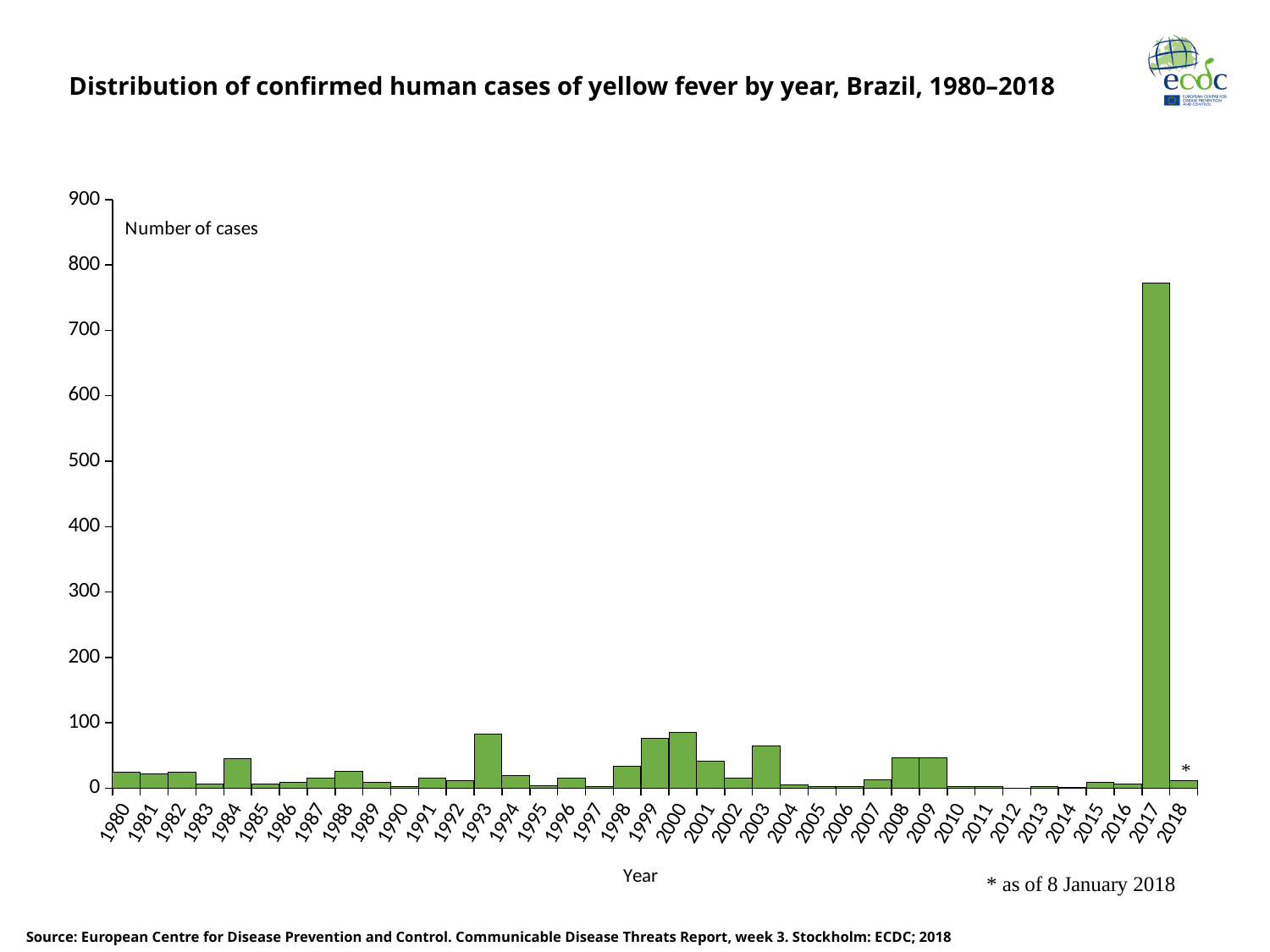
How many years are shown on the x axis of the chart? 39 Which year had more cases, 2003 or 2004? 2003 Is the number of cases in 2017 greater or less than 700? greater What does the asterisk next to the 2018 bar indicate? as of 8 January 2018 Is the number of cases in 1993 greater or less than 100? less Which year has the highest number of confirmed yellow fever cases? 2017 Which year had more cases, 1984 or 1983? 1984 Which year had more cases, 2017 or 2000? 2017 Is the number of cases in 2017 greater or less than 800? less What kind of chart is shown on the slide? bar chart What is the title of the chart? Distribution of confirmed human cases of yellow fever by year, Brazil, 1980–2018